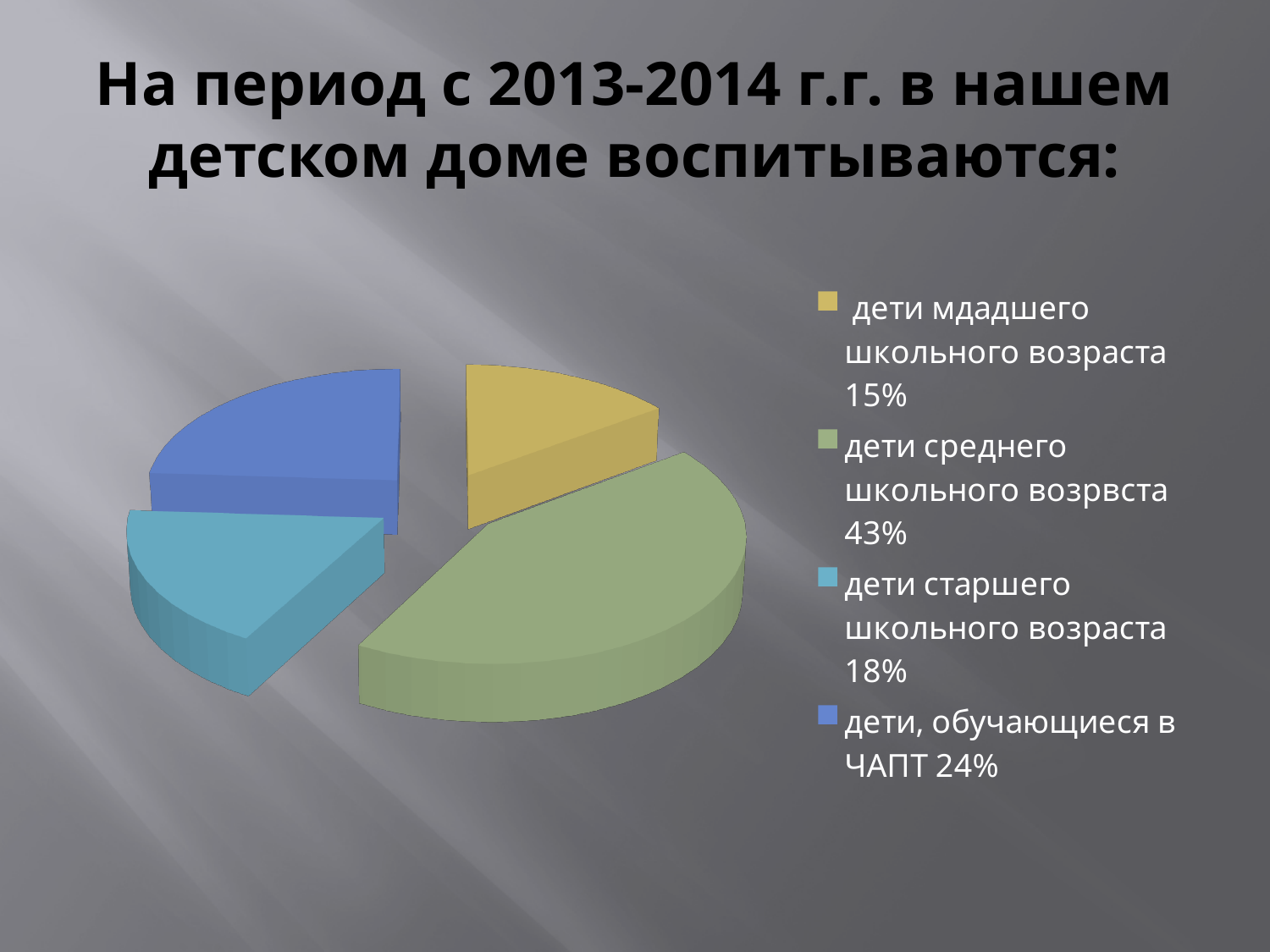
What percentage is shown for "дети, обучающиеся в ЧАПТ"? 24% Which is larger: the share for "дети старшего школьного возраста" or for "дети, обучающиеся в ЧАПТ"? дети, обучающиеся в ЧАПТ What is the difference in percentage points between "дети среднего школьного возраста" and "дети, обучающиеся в ЧАПТ"? 19 What colour is the slice for "дети среднего школьного возраста"? green Which category has the smallest share of the pie? дети младшего школьного возраста What colour is the slice for "дети, обучающиеся в ЧАПТ"? blue How many slices does the pie chart have? 4 What percentage is shown for "дети младшего школьного возраста"? 15% What percentage is shown for "дети среднего школьного возраста"? 43% What percentage is shown for "дети старшего школьного возраста"? 18% Which category has the largest share of the pie? дети среднего школьного возраста What kind of chart is shown on the slide? pie chart